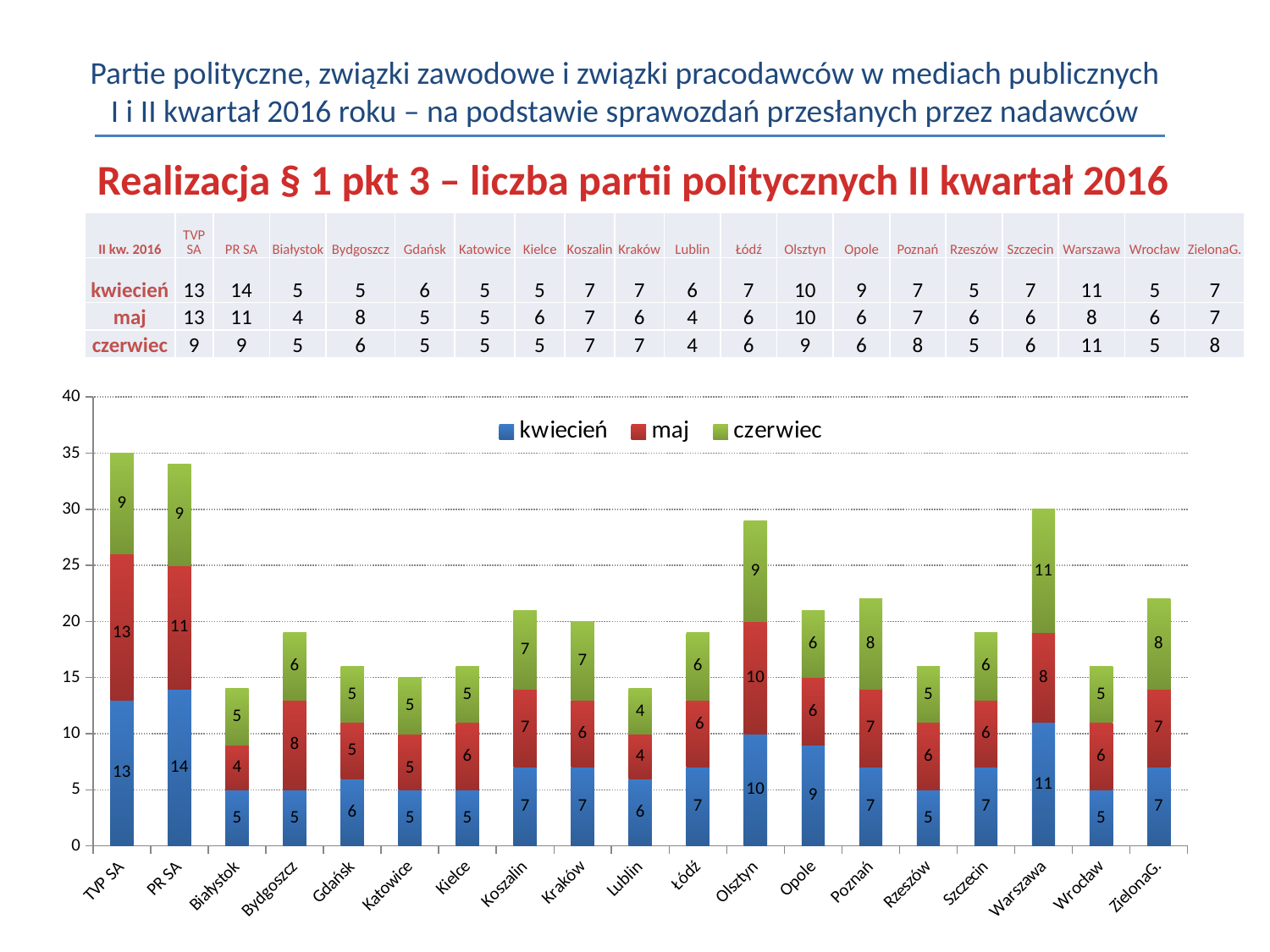
What is the total of the stacked bar for TVP SA? 35 What is the kwiecień value for PR SA in the chart? 14 What is the maj value for Olsztyn in the chart? 10 How many series does the chart legend list? 3 What type of chart is shown on the slide? stacked bar chart Which category has the highest kwiecień value in the chart? PR SA What is the total of the stacked bar for Olsztyn? 29 What is the difference between the czerwiec values for Warszawa and Wrocław? 6 Which category has the lowest czerwiec value in the chart? Lublin Which is larger: the maj value for Bydgoszcz or the maj value for Gdańsk? Bydgoszcz What is the czerwiec value for Warszawa in the chart? 11 How many categories (broadcasters) are shown on the x axis of the chart? 19